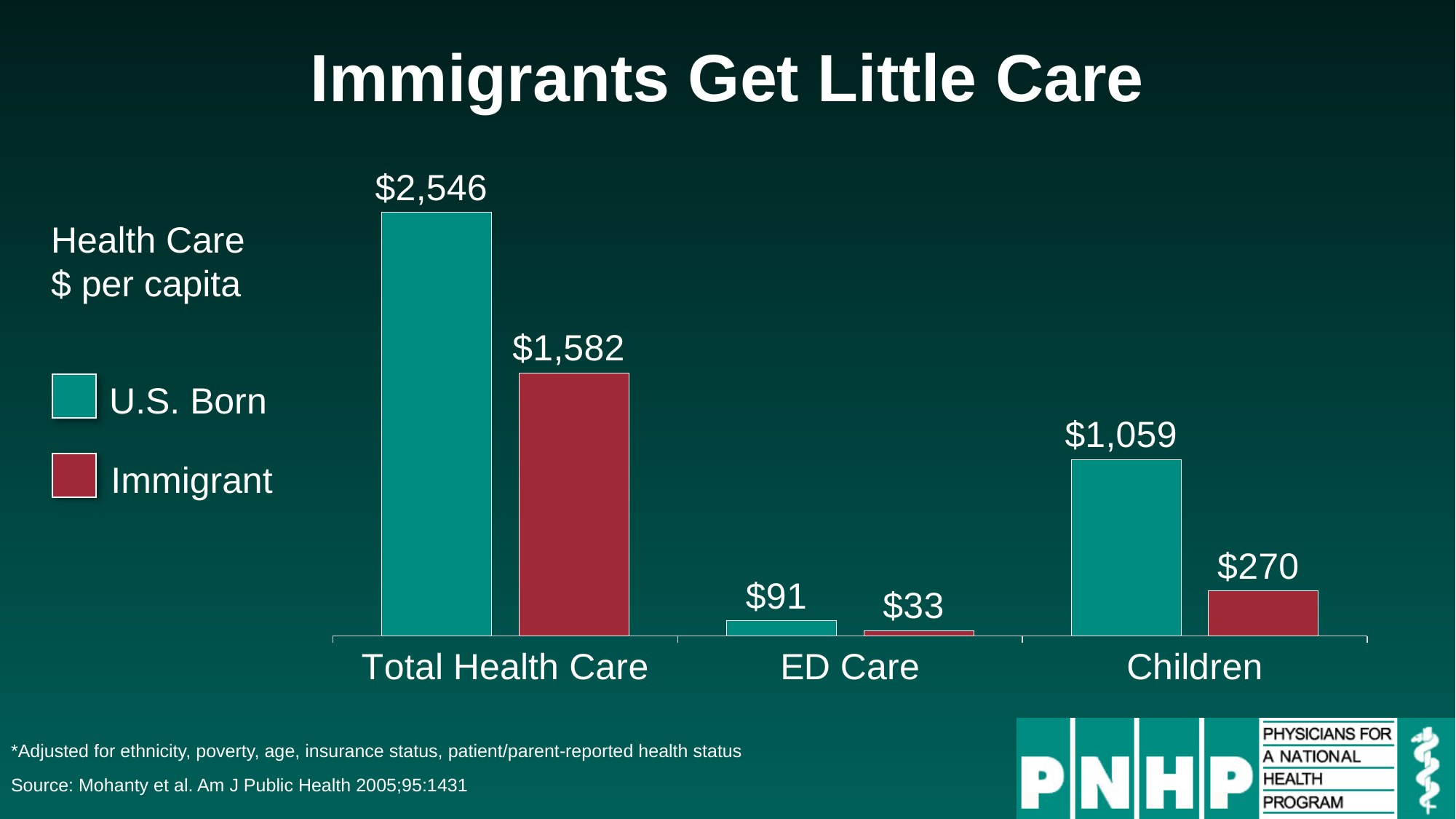
What is the difference between the U.S. Born and Immigrant values for Children? $789 How many categories are shown on the x axis? 3 What is the Total Health Care value for U.S. Born? $2,546 How many series does the legend list? 2 Which category has the lowest Immigrant value? ED Care What is the ED Care value for Immigrant? $33 What is the Total Health Care value for Immigrant? $1,582 What is the Children value for U.S. Born? $1,059 Which category has the highest U.S. Born value? Total Health Care What kind of chart is shown on the slide? Bar chart For ED Care, which is larger: the U.S. Born value or the Immigrant value? U.S. Born What is the difference between the U.S. Born and Immigrant values for Total Health Care? $964